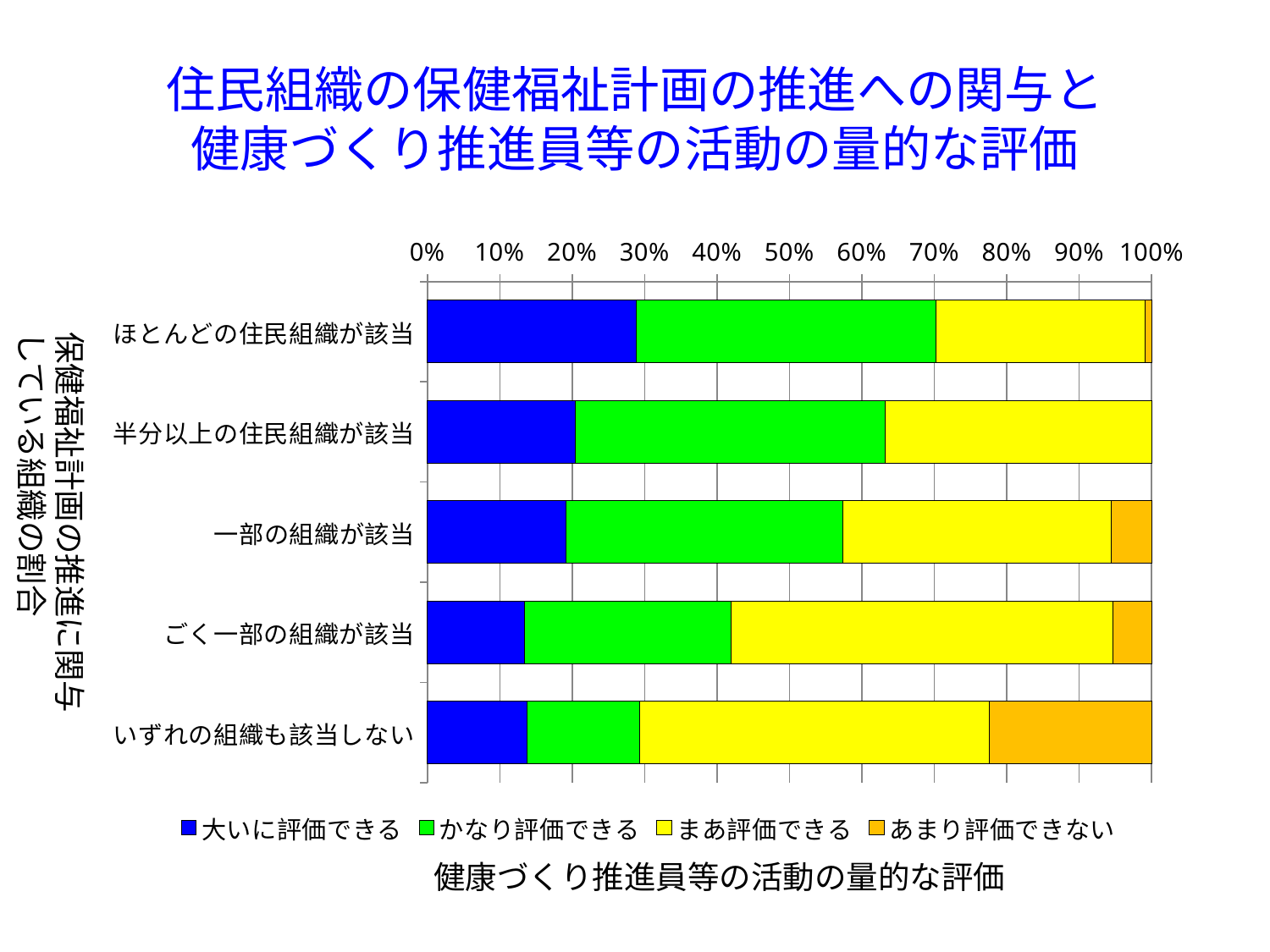
Which has the larger 大いに評価できる share: ほとんどの住民組織が該当 or 半分以上の住民組織が該当? ほとんどの住民組織が該当 Is the かなり評価できる share for いずれの組織も該当しない greater or less than 20%? less Which category has the largest あまり評価できない share? いずれの組織も該当しない Is the あまり評価できない share for いずれの組織も該当しない greater or less than 10%? greater What is the first entry in the chart's legend? 大いに評価できる Is the 大いに評価できる share for ほとんどの住民組織が該当 greater or less than 20%? greater How many series does the legend list? 4 Which category has the largest 大いに評価できる share? ほとんどの住民組織が該当 How many categories are plotted on the vertical axis of the chart? 5 What kind of chart is shown on the slide? Stacked bar chart